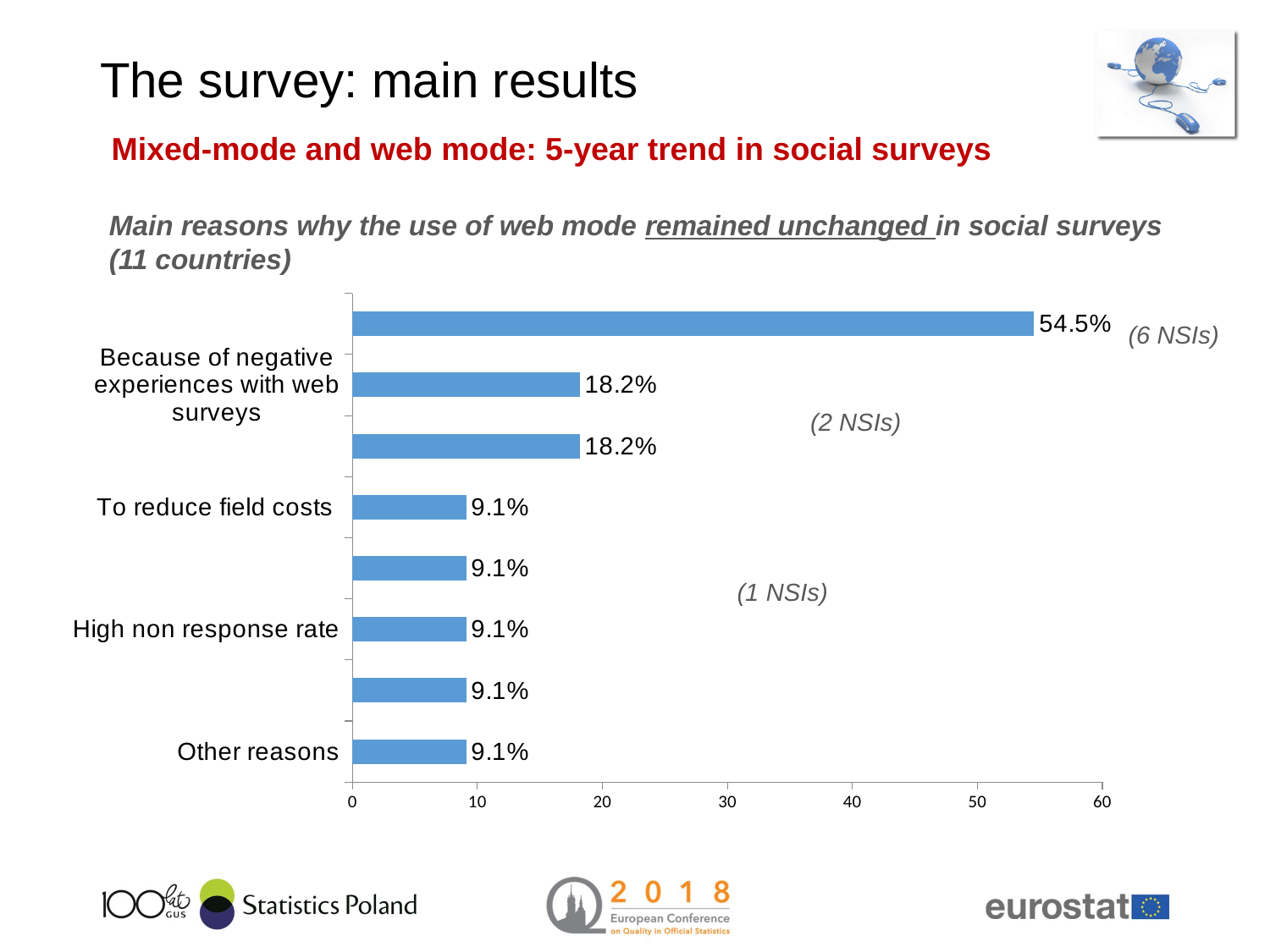
How many bars are plotted in the chart? 8 Which is larger: the value for 'Because of negative experiences with web surveys' or the value for 'To reduce field costs'? Because of negative experiences with web surveys What kind of chart is shown on the slide? bar chart What is the value for 'High non response rate'? 9.1% What is the value for 'Because of negative experiences with web surveys'? 18.2% Is the value of the longest bar greater or less than 50? greater What is the lowest value shown in the chart? 9.1% What is the highest value shown in the chart? 54.5% What is the difference between the highest value (54.5%) and the value for 'Because of negative experiences with web surveys'? 36.3 percentage points What is the value for 'Other reasons'? 9.1% What is the value for 'To reduce field costs'? 9.1% What annotation is written next to the longest bar in the chart? (6 NSIs)